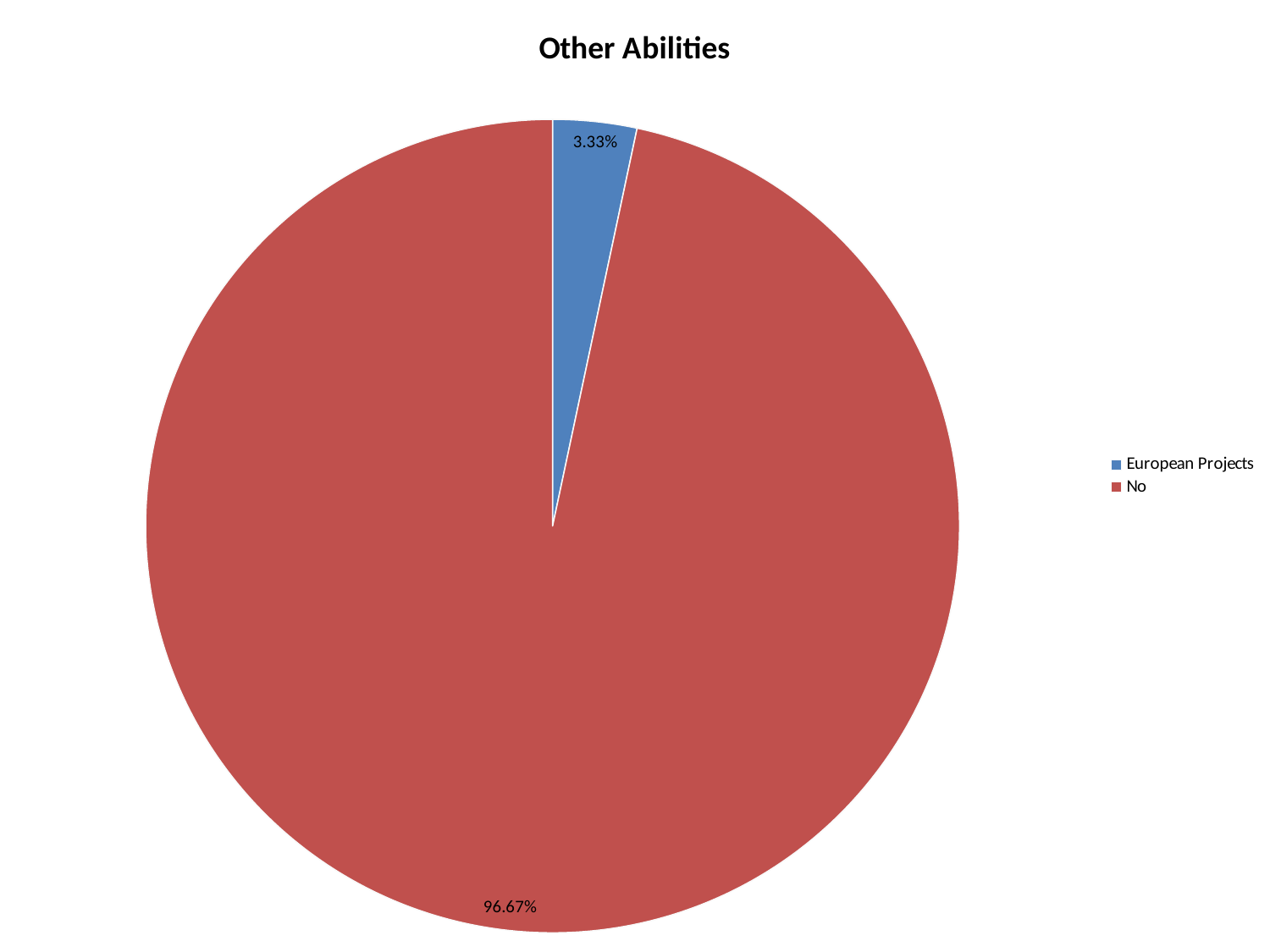
What type of chart is shown on the slide? pie chart Which slice is the smallest? European Projects What colour is the European Projects slice? blue Which slice is the largest? No How many slices does the pie chart have? 2 What percentage of the pie is labelled European Projects? 3.33% Which is larger, the share for No or the share for European Projects? No What percentage of the pie is labelled No? 96.67% How many entries does the legend list? 2 What is the title of the chart? Other Abilities What is the difference in percentage points between the No slice and the European Projects slice? 93.34